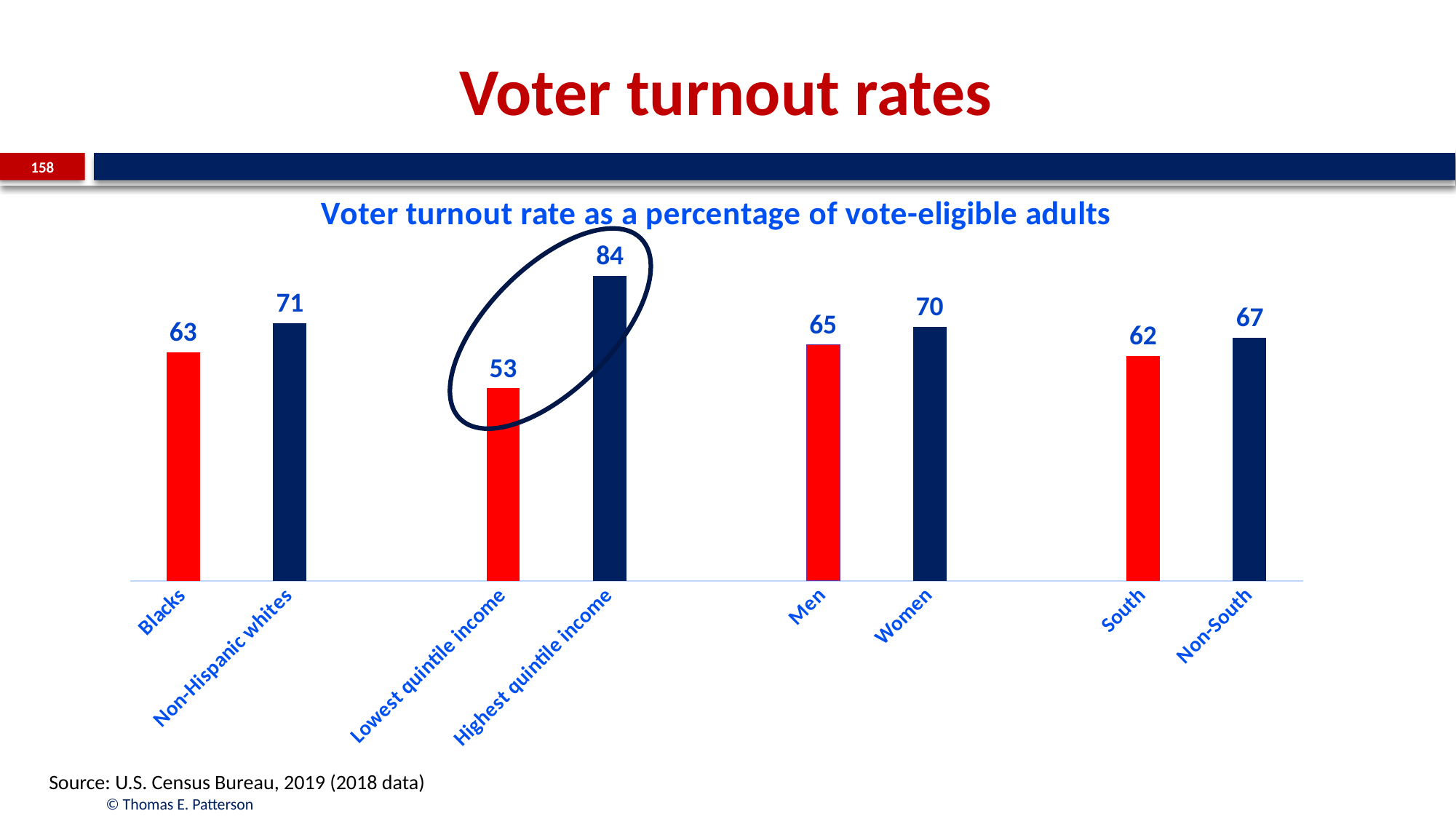
What is the difference between the turnout rates for Highest quintile income and Lowest quintile income? 31 Which category has the lowest voter turnout rate? Lowest quintile income What is the voter turnout rate for South? 62 What is the voter turnout rate for Blacks? 63 What is the voter turnout rate for Women? 70 How many categories are shown in the chart? 8 What is the voter turnout rate for Highest quintile income? 84 What is the difference between the turnout rates for Non-Hispanic whites and Blacks? 8 Which has a higher voter turnout rate, Men or Women? Women What is the title of the chart? Voter turnout rate as a percentage of vote-eligible adults What kind of chart is shown on the slide? Bar chart Which category has the highest voter turnout rate? Highest quintile income